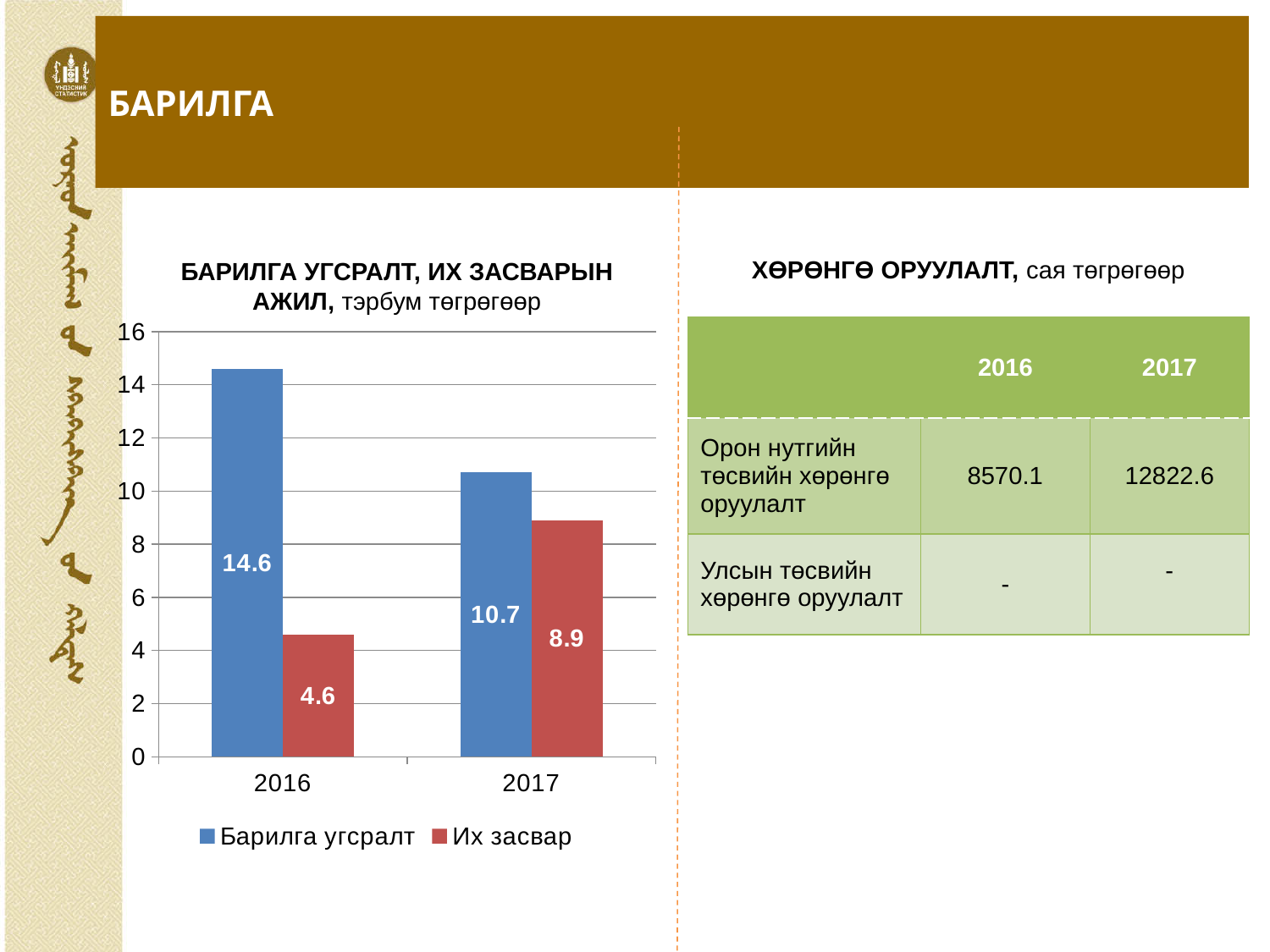
What is the difference between Барилга угсралт and Их засвар in 2016? 10.0 How many years are shown on the x axis? 2 What is the value for Барилга угсралт in 2017? 10.7 What is the value for Барилга угсралт in 2016? 14.6 Which year has the lowest value for Их засвар? 2016 Does the value for Барилга угсралт rise or fall from 2016 to 2017? Fall What is the value for Их засвар in 2016? 4.6 Which year has the highest value for Барилга угсралт? 2016 What is the value for Их засвар in 2017? 8.9 How many series does the legend list? 2 Which is larger in 2017, Барилга угсралт or Их засвар? Барилга угсралт What kind of chart is shown on the slide? Bar chart